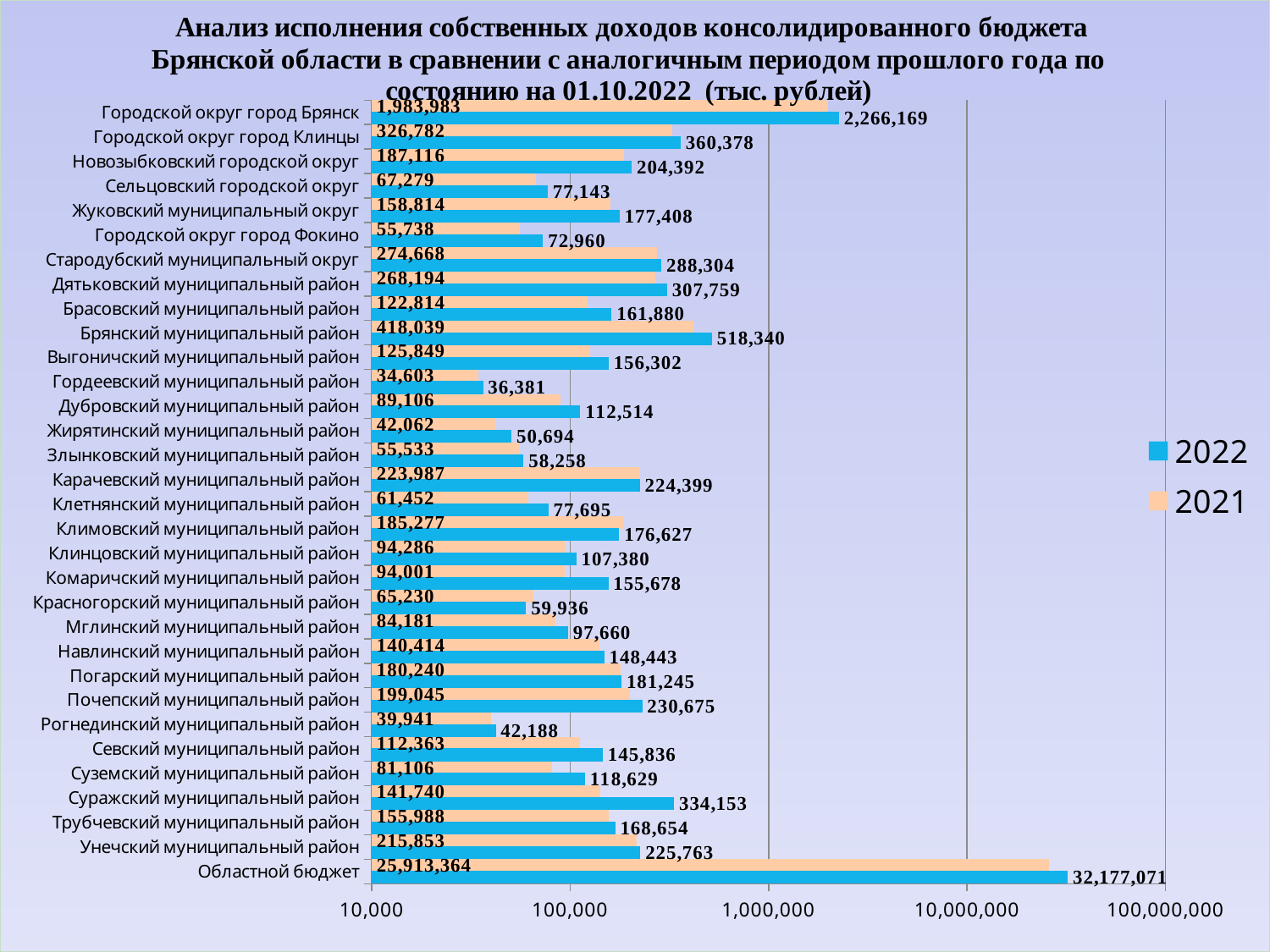
What is the 2021 value for Суражский муниципальный район? 141,740 Which is larger for Красногорский муниципальный район, the 2022 value or the 2021 value? 2021 How many categories are shown on the chart? 32 What is the 2022 value for Областной бюджет? 32,177,071 What is the 2022 value for Городской округ город Брянск? 2,266,169 Which category has the lowest 2022 value? Гордеевский муниципальный район How many series does the legend list? 2 Which category has the highest 2022 value? Областной бюджет What is the 2021 value for Брянский муниципальный район? 418,039 What is the difference between the 2022 and 2021 values for Городской округ город Клинцы? 33,596 Which colour represents the 2021 series in the legend? orange What kind of chart is shown on the slide? bar chart